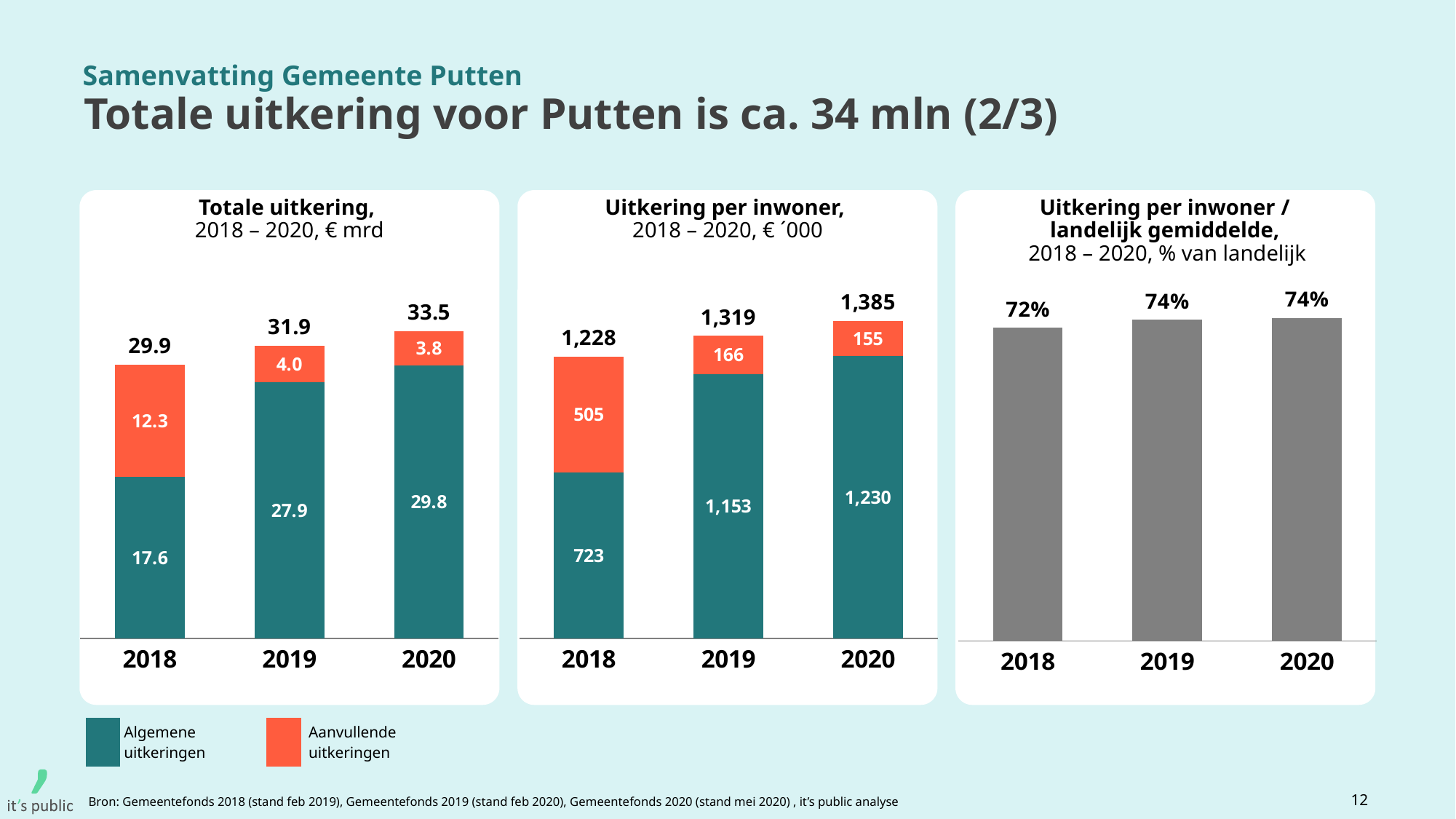
In the 'Totale uitkering' chart, what is the value of Algemene uitkeringen for 2018? 17.6 In the 'Uitkering per inwoner / landelijk gemiddelde' chart, what is the value for 2018? 72% How many series does the legend at the bottom of the slide list? 2 In the 'Uitkering per inwoner / landelijk gemiddelde' chart, how many years are shown? 3 In the 'Totale uitkering' chart, what is the value of Aanvullende uitkeringen for 2019? 4.0 In the 'Uitkering per inwoner' chart, what is the difference between the Aanvullende uitkeringen values for 2018 and 2019? 339 What kind of chart is the 'Totale uitkering' chart? stacked bar chart In the 'Uitkering per inwoner' chart, do the totals rise or fall from 2018 to 2020? rise In the 'Totale uitkering' chart, which year has the lowest total? 2018 In the 'Uitkering per inwoner' chart, what is the value of Algemene uitkeringen for 2020? 1,230 In the 'Totale uitkering' chart, what is the total of the stacked bar for 2020? 33.5 In the 'Uitkering per inwoner' chart, what is the total for 2019? 1,319